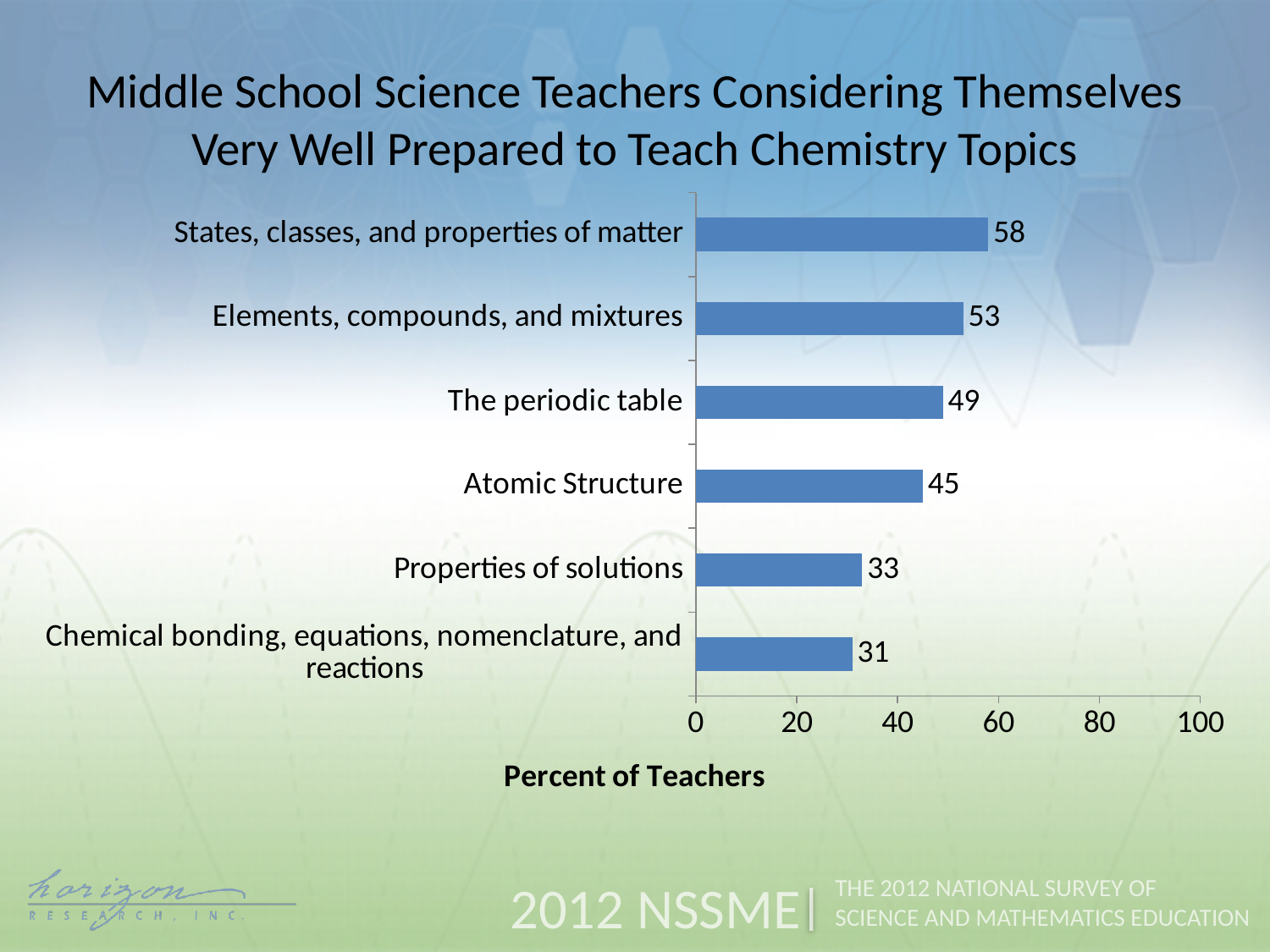
Which topic has the highest percent of teachers? States, classes, and properties of matter What kind of chart is shown on the slide? Bar chart What is the value for Properties of solutions? 33 How many topics are shown in the chart? 6 Is the value for Atomic Structure greater or less than 40? greater What is the maximum value shown on the horizontal axis? 100 What is the difference between the values for Elements, compounds, and mixtures and Atomic Structure? 8 Which is larger, the value for The periodic table or the value for Properties of solutions? The periodic table What is the label of the horizontal axis? Percent of Teachers What percent of teachers consider themselves very well prepared to teach states, classes, and properties of matter? 58 What is the value for The periodic table? 49 Which topic has the lowest percent of teachers? Chemical bonding, equations, nomenclature, and reactions